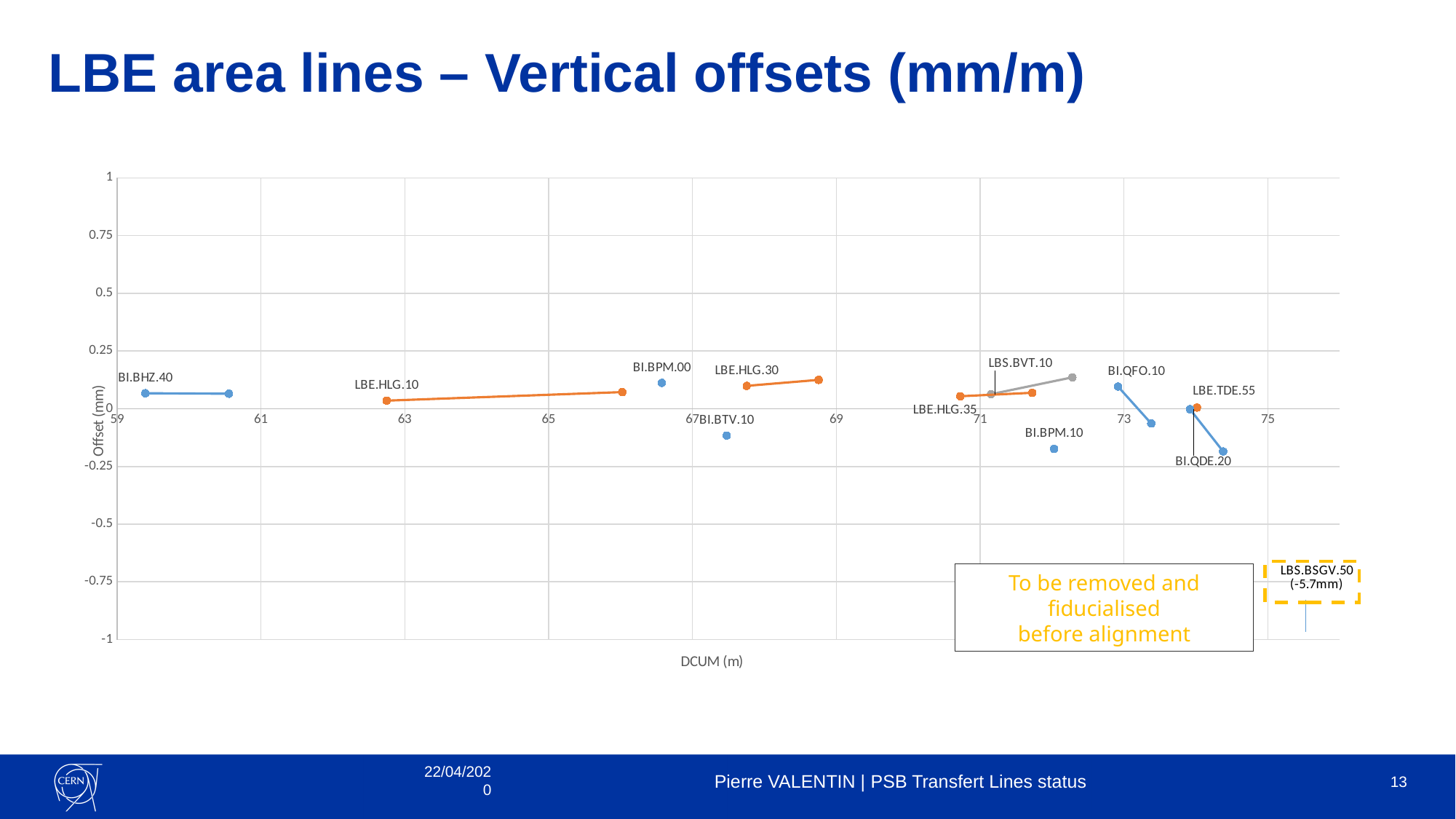
Which has the higher offset, BI.QFO.10 or BI.QDE.20? BI.QFO.10 What is the label of the horizontal axis of the chart? DCUM (m) Which has the higher offset, BI.BPM.00 or BI.BTV.10? BI.BPM.00 Is the offset value for BI.BPM.00 greater or less than 0? greater Does the line for BI.QFO.10 rise or fall as DCUM increases? fall Is the offset value for BI.BTV.10 greater or less than 0? less Does the line for LBE.HLG.10 rise or fall as DCUM increases? rise What kind of chart is shown on the slide? Scatter chart Is the offset value for BI.BHZ.40 greater or less than 0.25? less What offset value is given for LBS.BSGV.50 in the dashed box? -5.7mm What is the label of the vertical axis of the chart? Offset (mm)